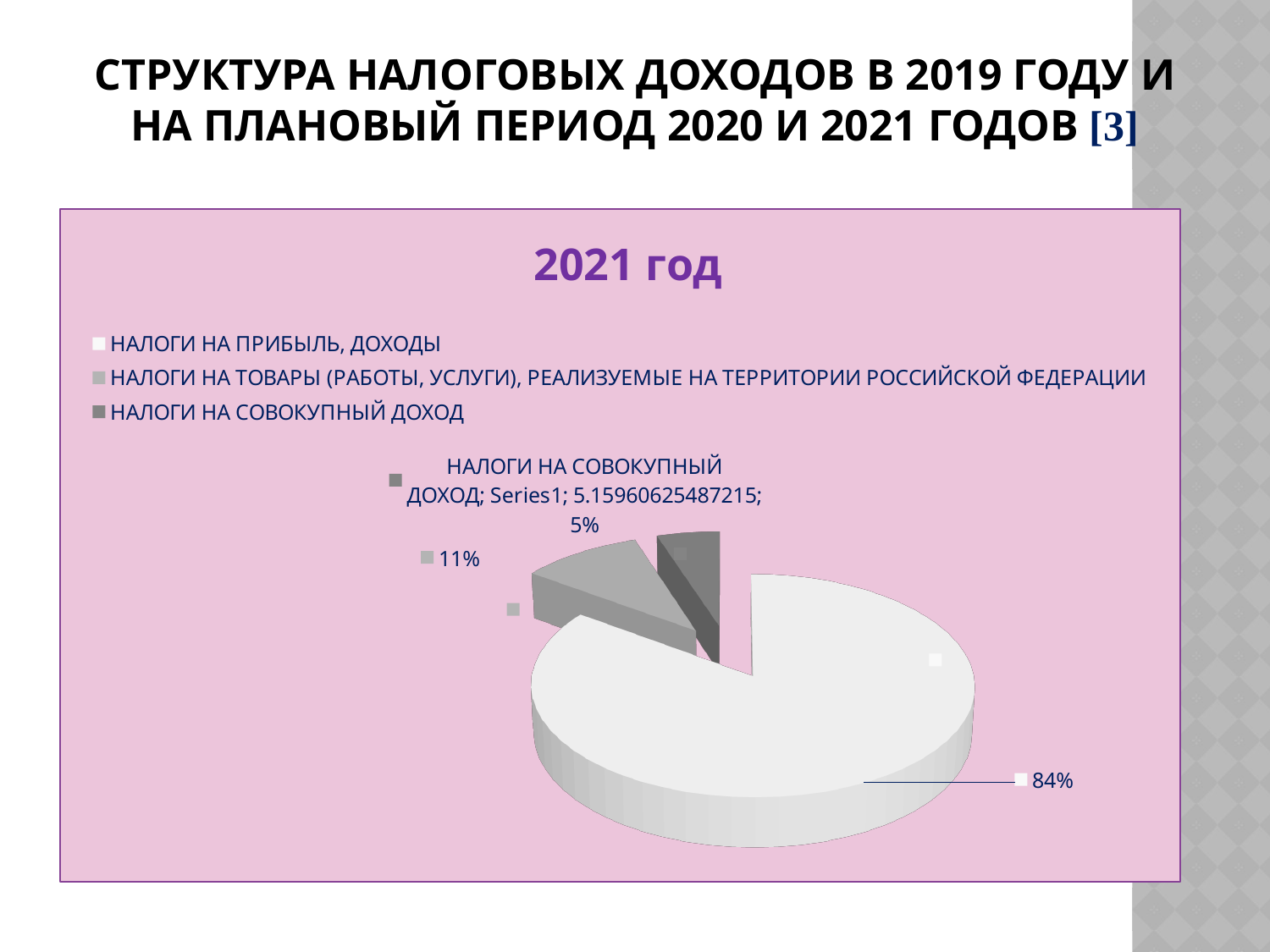
Which category has the largest slice of the pie? НАЛОГИ НА ПРИБЫЛЬ, ДОХОДЫ What kind of chart is shown on the slide? pie chart What share of the pie does НАЛОГИ НА ТОВАРЫ (РАБОТЫ, УСЛУГИ), РЕАЛИЗУЕМЫЕ НА ТЕРРИТОРИИ РОССИЙСКОЙ ФЕДЕРАЦИИ have? 11% Which category has the smallest slice of the pie? НАЛОГИ НА СОВОКУПНЫЙ ДОХОД What unrounded value is printed in the data label for НАЛОГИ НА СОВОКУПНЫЙ ДОХОД? 5.15960625487215 What is the difference in percentage points between the share for НАЛОГИ НА ТОВАРЫ (РАБОТЫ, УСЛУГИ), РЕАЛИЗУЕМЫЕ НА ТЕРРИТОРИИ РОССИЙСКОЙ ФЕДЕРАЦИИ and the share for НАЛОГИ НА СОВОКУПНЫЙ ДОХОД? 6 What is the title of the chart? 2021 год How many categories does the legend of the pie chart list? 3 Which is larger: the share for НАЛОГИ НА ТОВАРЫ (РАБОТЫ, УСЛУГИ), РЕАЛИЗУЕМЫЕ НА ТЕРРИТОРИИ РОССИЙСКОЙ ФЕДЕРАЦИИ or the share for НАЛОГИ НА СОВОКУПНЫЙ ДОХОД? НАЛОГИ НА ТОВАРЫ (РАБОТЫ, УСЛУГИ), РЕАЛИЗУЕМЫЕ НА ТЕРРИТОРИИ РОССИЙСКОЙ ФЕДЕРАЦИИ What is the difference in percentage points between the share for НАЛОГИ НА ПРИБЫЛЬ, ДОХОДЫ and the share for НАЛОГИ НА ТОВАРЫ (РАБОТЫ, УСЛУГИ), РЕАЛИЗУЕМЫЕ НА ТЕРРИТОРИИ РОССИЙСКОЙ ФЕДЕРАЦИИ? 73 What share of the pie does НАЛОГИ НА СОВОКУПНЫЙ ДОХОД have? 5% What share of the pie does НАЛОГИ НА ПРИБЫЛЬ, ДОХОДЫ have? 84%